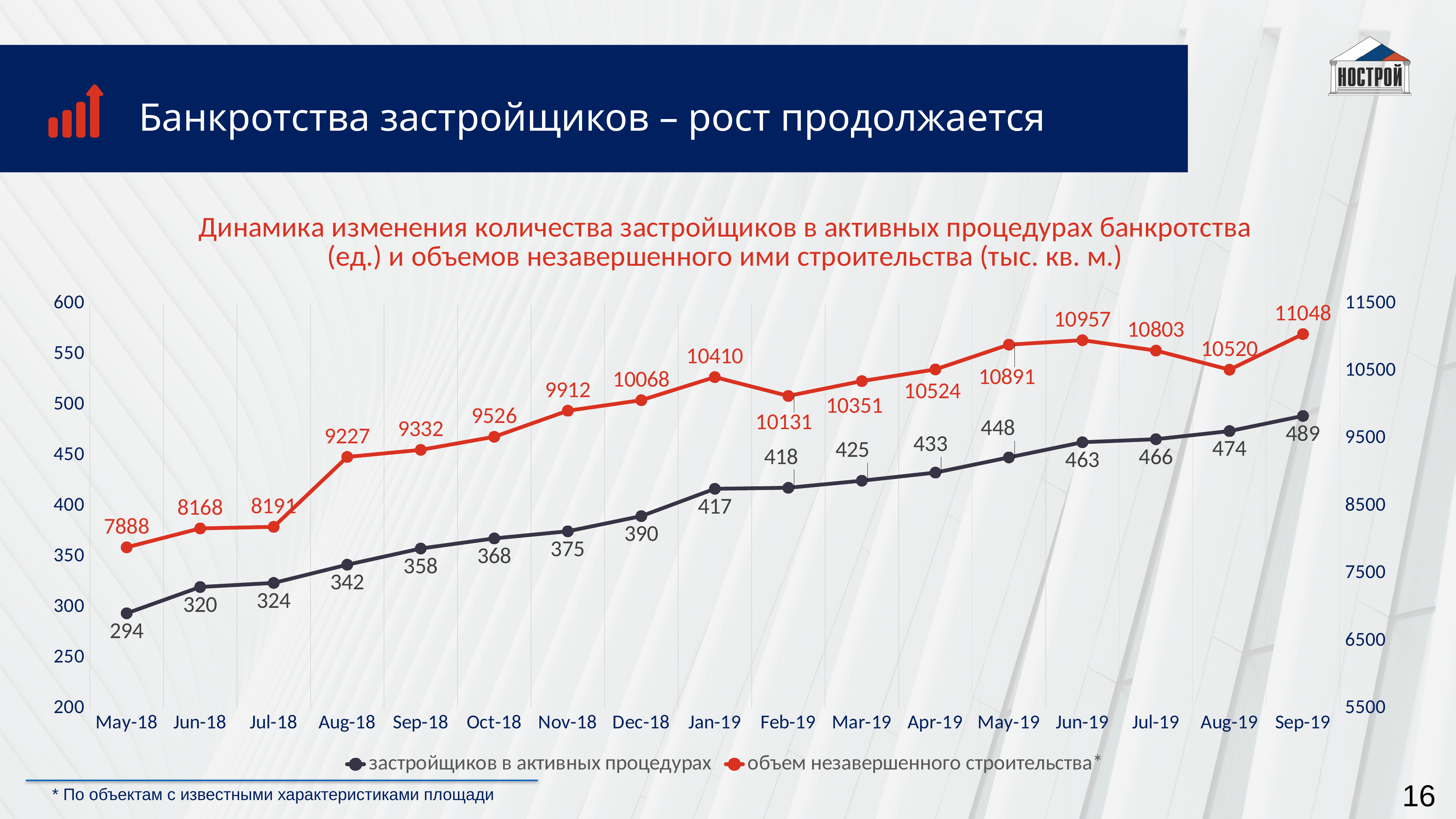
Which is larger for 'объем незавершенного строительства': Jun-19 or Jul-19? Jun-19 How many series does the legend list? 2 In which month is 'застройщиков в активных процедурах' lowest? May-18 What is the difference between the 'застройщиков в активных процедурах' values for Sep-19 and May-18? 195 In which month is 'объем незавершенного строительства' highest? Sep-19 What is the value of 'объем незавершенного строительства' for Feb-19? 10131 What colour is the line for 'объем незавершенного строительства'? red What is the difference between the 'объем незавершенного строительства' values for Jan-19 and Feb-19? 279 How many months are plotted along the x axis? 17 What is the value of 'застройщиков в активных процедурах' for Dec-18? 390 What kind of chart is shown on the slide? line chart Does 'застройщиков в активных процедурах' generally rise or fall from May-18 to Sep-19? rise